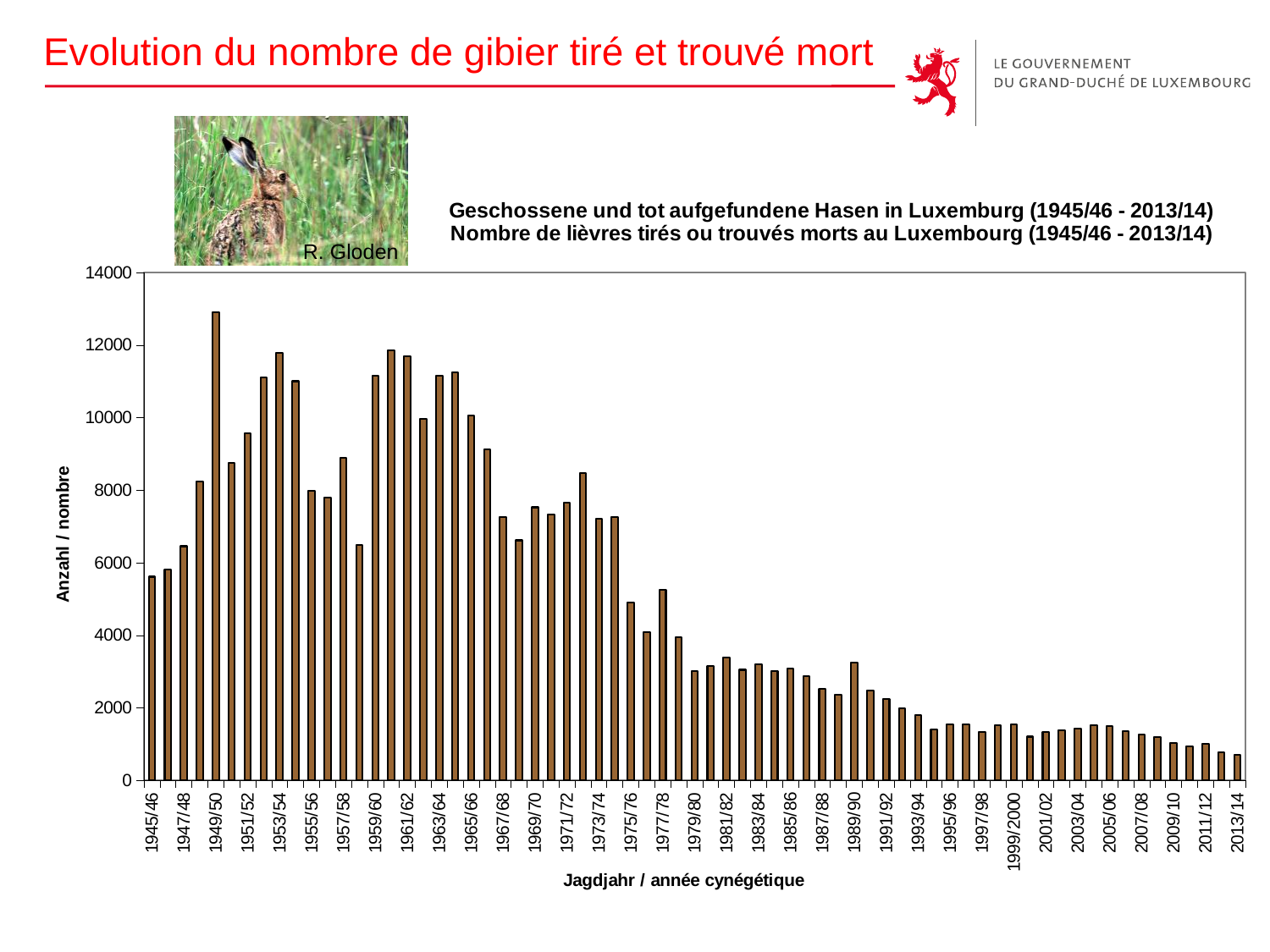
Which is larger, the value for 1949/50 or the value for 1959/60? 1949/50 Which hunting year has the highest number of hares shot or found dead? 1949/50 Is the value for 1979/80 greater or less than 2000? greater What is the label of the horizontal axis? Jagdjahr / année cynégétique Which is larger, the value for 1945/46 or the value for 1947/48? 1947/48 Overall, do the values rise or fall from 1945/46 to 2013/14? fall What kind of chart is shown on the slide? bar chart Is the value for 2013/14 greater or less than 2000? less What is the label of the vertical axis? Anzahl / nombre Is the value for 1945/46 greater or less than 6000? less